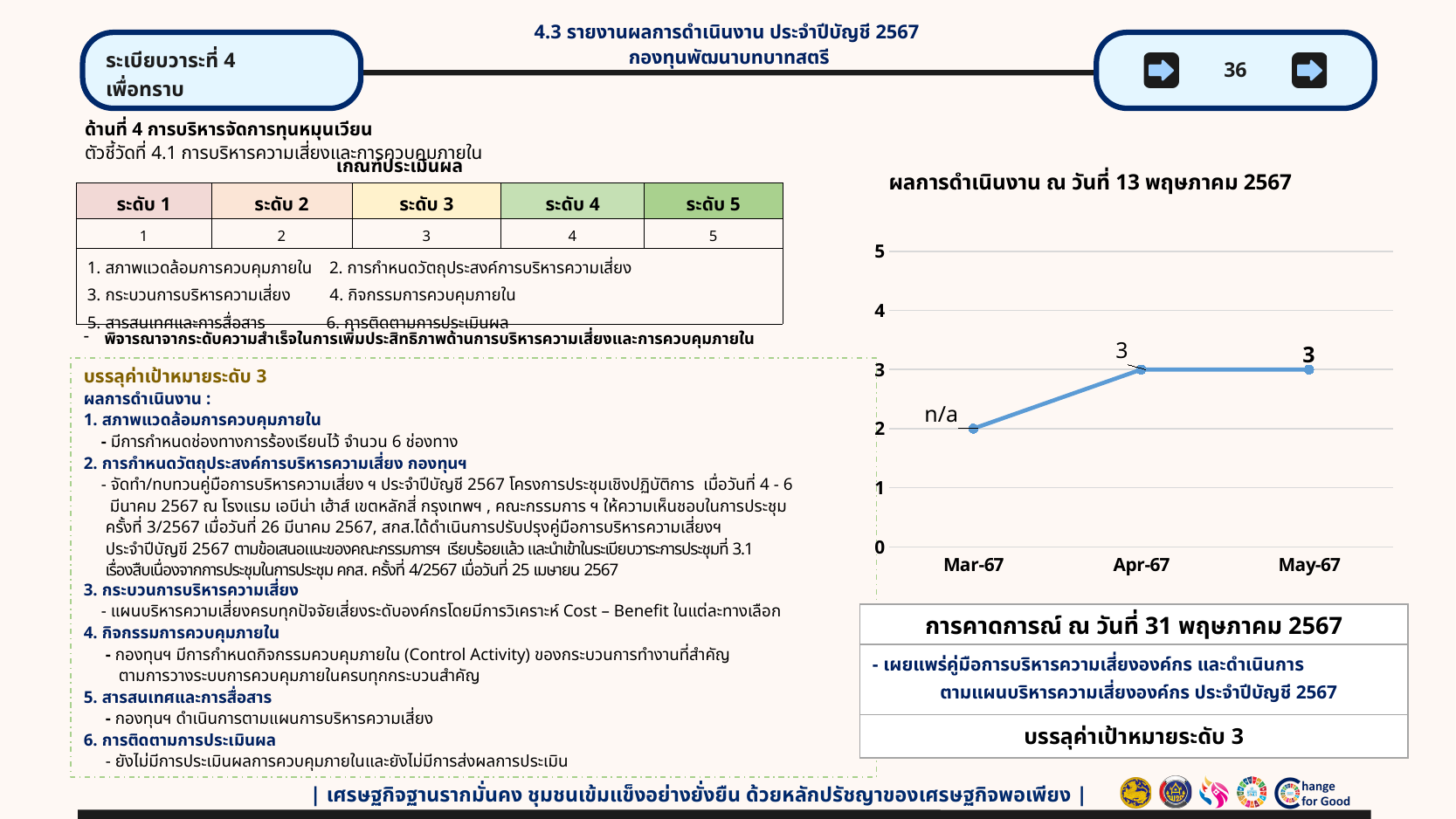
How many points are plotted on the line chart? 3 Does the line rise or fall from Mar-67 to Apr-67? rise Which month has the lowest plotted value? Mar-67 What kind of chart is shown on the slide? line chart What is the value plotted for May-67? 3 What data label is shown at the Mar-67 point? n/a Which is larger, the plotted value for Mar-67 or for Apr-67? Apr-67 What is the highest value shown on the y axis? 5 What is the value plotted for Apr-67? 3 What is the title of the chart? ผลการดำเนินงาน ณ วันที่ 13 พฤษภาคม 2567 Is the plotted value for Apr-67 greater or less than 2? greater Is the plotted value for Mar-67 greater or less than 3? less